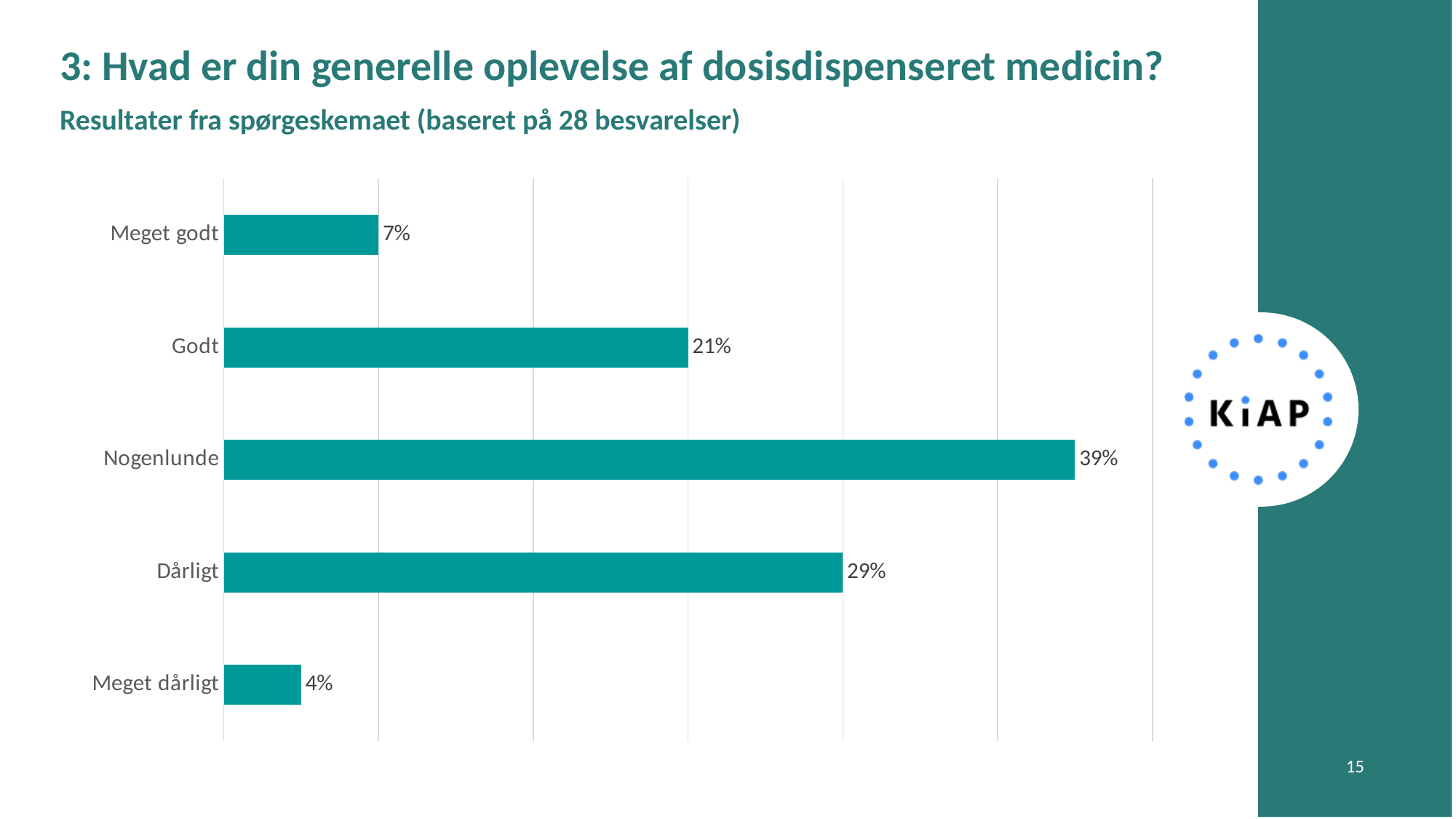
How many categories are shown in the chart? 5 Which category has the lowest value? Meget dårligt What is the difference between the values for Nogenlunde and Dårligt? 10% What is the value for Meget dårligt? 4% What is the value for Meget godt? 7% Which category has the highest value? Nogenlunde What kind of chart is shown on the slide? Bar chart What is the value for Nogenlunde? 39% What is the value for Dårligt? 29% How many responses is the chart based on, according to the subtitle? 28 Which is larger, the value for Godt or the value for Dårligt? Dårligt What is the difference between the values for Godt and Meget godt? 14%